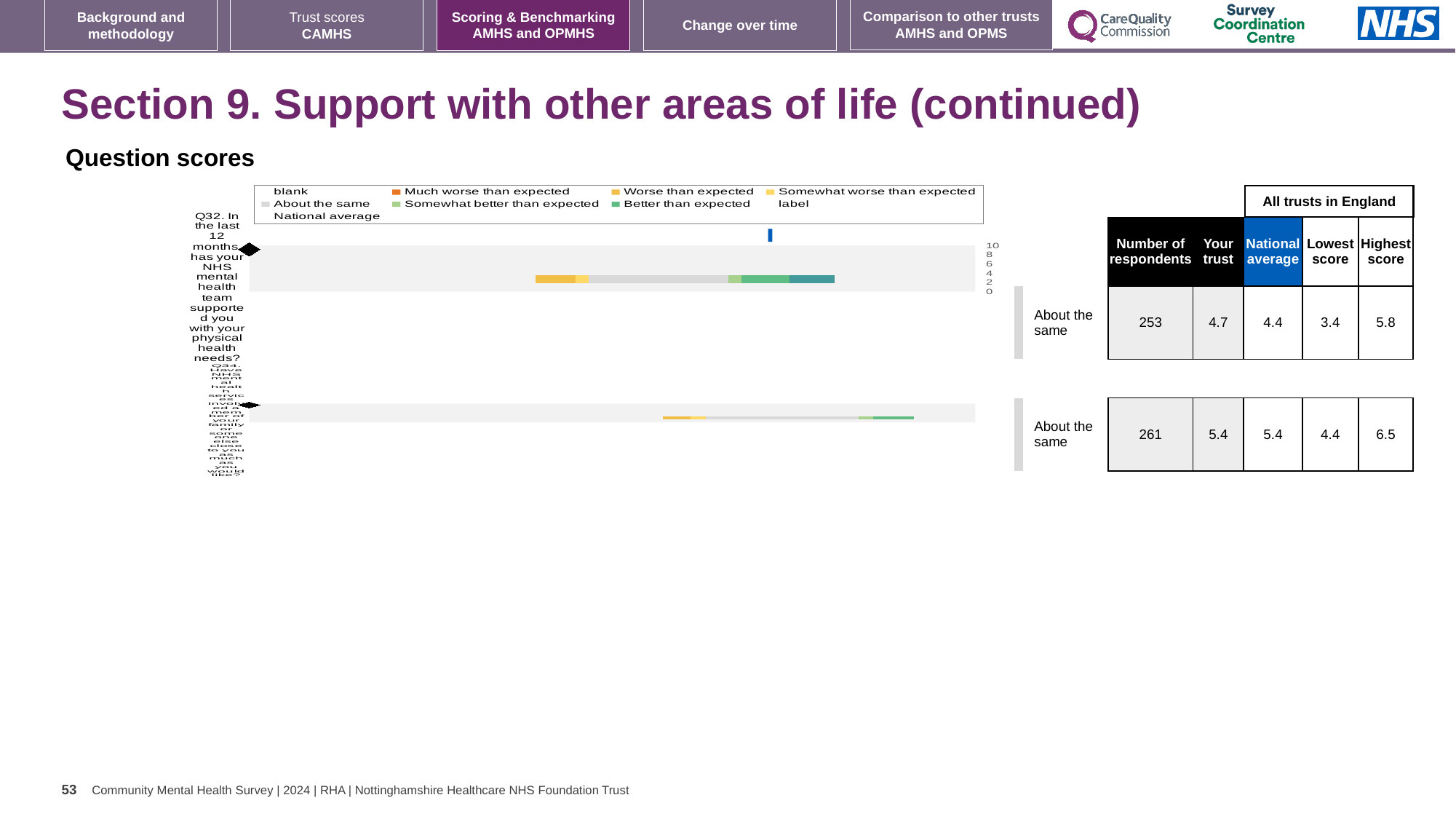
How many questions (bars) are plotted in the chart? 2 In the table beside the chart, what is the national average for Q34? 5.4 In the table beside the chart, what is the highest score for Q34? 6.5 Which question has more respondents in the table, Q32 or Q34? Q34 What is the highest tick value shown on the chart's axis? 10 What colour is the 'About the same' segment in the chart legend? grey In the table beside the chart, what is the 'Your trust' score for Q32? 4.7 For Q32, is the 'Your trust' score or the national average larger in the table? Your trust In the table beside the chart, how many respondents are listed for Q32? 253 What is the difference between the highest score and the lowest score for Q32 in the table? 2.4 What benchmark category is shown next to both Q32 and Q34? About the same What kind of chart is shown under 'Question scores'? bar chart